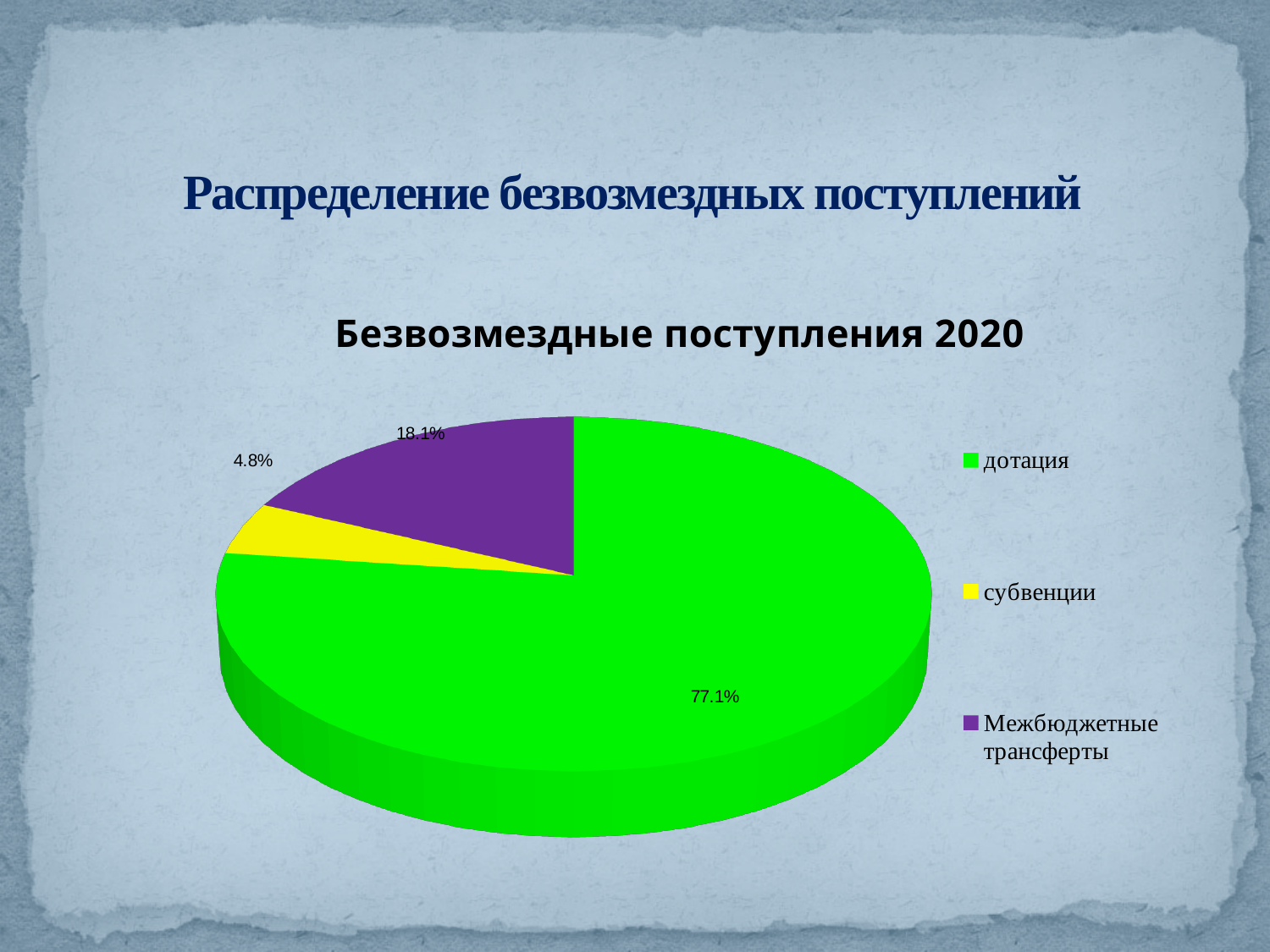
What is the difference between the share for Межбюджетные трансферты and the share for субвенции? 13.3% Which is larger, the share for субвенции or the share for Межбюджетные трансферты? Межбюджетные трансферты What share of the pie does Межбюджетные трансферты have? 18.1% What kind of chart is shown on the slide? pie chart What share of the pie does субвенции have? 4.8% Which category has the smallest share of the pie? субвенции How many categories does the pie chart show? 3 What is the title of the chart? Безвозмездные поступления 2020 What is the difference between the share for дотация and the share for Межбюджетные трансферты? 59.0% Which category has the largest share of the pie? дотация What share of the pie does дотация have? 77.1% What colour is the slice for субвенции? yellow